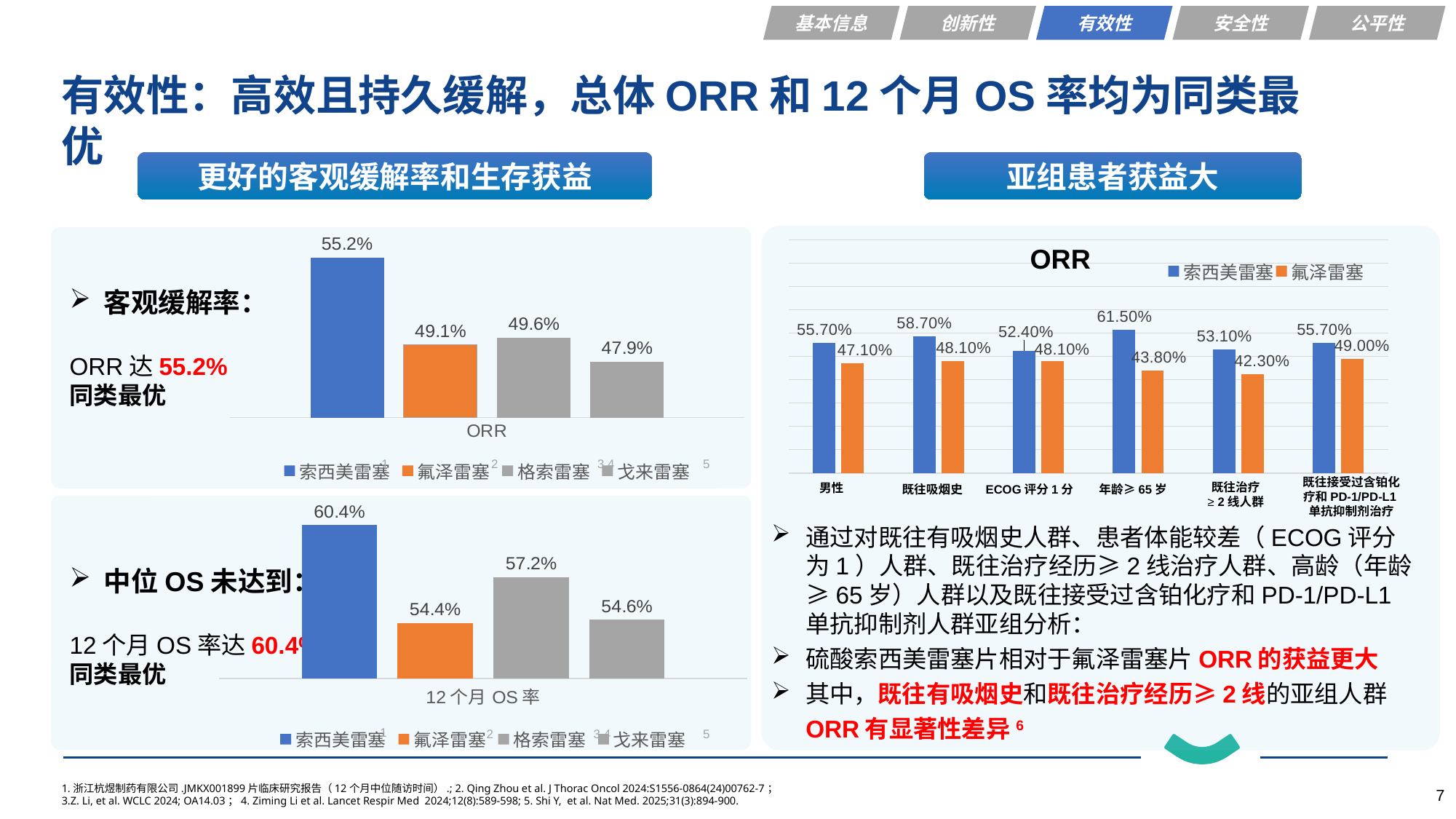
In the top-left ORR chart, which drug has the lowest ORR? 戈来雷塞 In the bottom-left 12 个月 OS 率 chart, what is the value for 格索雷塞? 57.2% In the top-left ORR chart, what is the ORR value for 索西美雷塞? 55.2% In the right-hand ORR subgroup chart, how many series does the legend list? 2 In the right-hand ORR subgroup chart, what is the ORR of 索西美雷塞 in the 年龄≥65岁 subgroup? 61.50% In the right-hand ORR subgroup chart, what is the difference between 索西美雷塞 and 氟泽雷塞 in the 年龄≥65岁 subgroup? 17.70 percentage points In the top-left ORR chart, what is the difference between the ORR of 索西美雷塞 and 氟泽雷塞? 6.1 percentage points In the top-left ORR chart, how many drugs are compared? 4 What type of chart is the bottom-left 12 个月 OS 率 chart? Bar chart In the bottom-left 12 个月 OS 率 chart, which is larger: the value for 氟泽雷塞 or 戈来雷塞? 戈来雷塞 In the bottom-left 12 个月 OS 率 chart, which drug has the highest 12-month OS rate? 索西美雷塞 In the right-hand ORR subgroup chart, what is the ORR of 氟泽雷塞 in the 既往治疗≥2线人群 subgroup? 42.30%